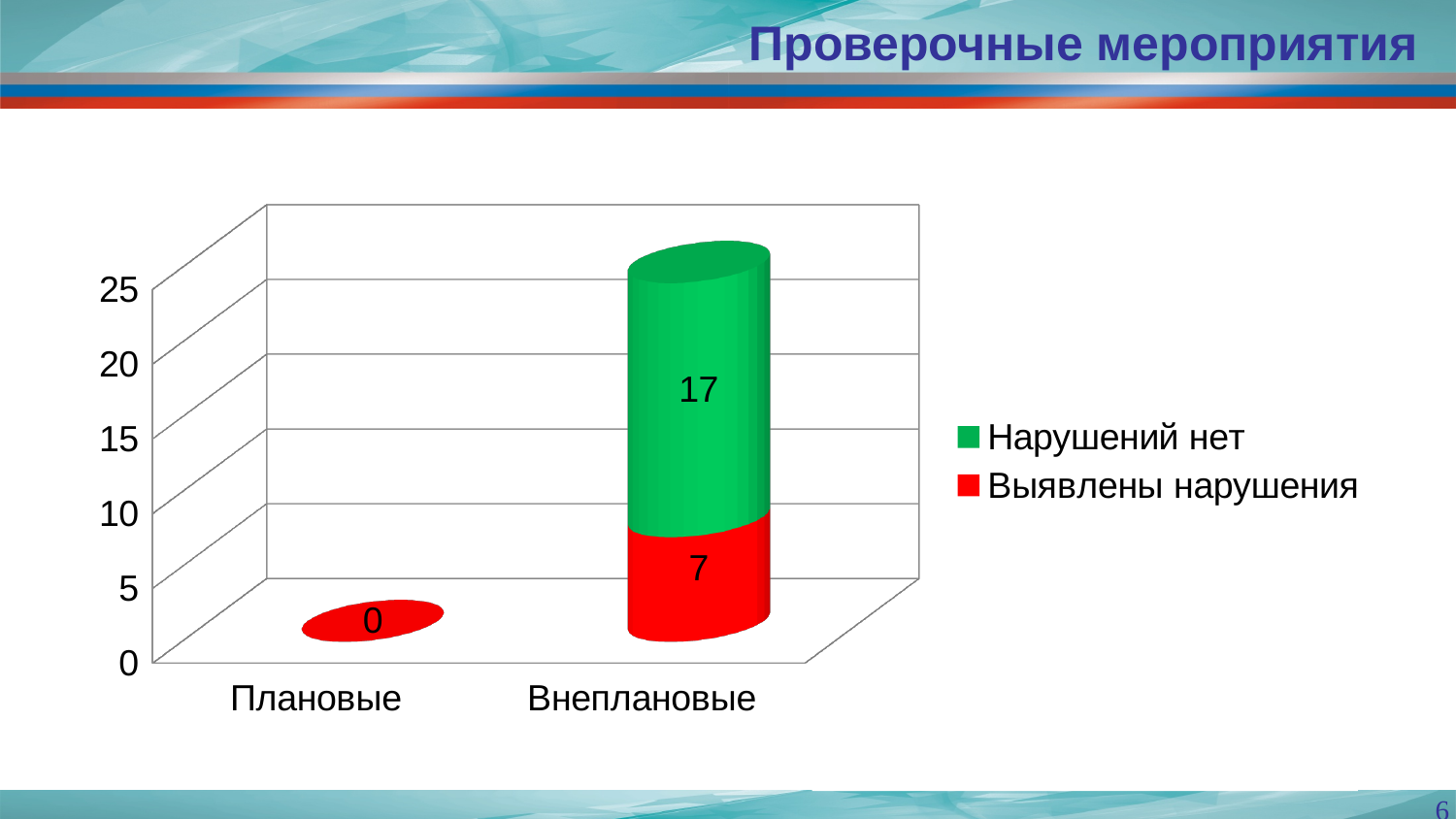
What kind of chart is shown on the slide? Bar chart What colour represents the 'Выявлены нарушения' series? Red For the 'Внеплановые' category, which series has the larger value: 'Нарушений нет' or 'Выявлены нарушения'? Нарушений нет What is the value of the 'Нарушений нет' series for the 'Внеплановые' category? 17 What is the title of the slide? Проверочные мероприятия What is the difference between the 'Нарушений нет' and 'Выявлены нарушения' values for 'Внеплановые'? 10 Which category has the taller stacked bar? Внеплановые How many series does the legend list? 2 What is the value of the 'Выявлены нарушения' series for the 'Плановые' category? 0 What is the total of the stacked bar for 'Внеплановые'? 24 What is the value of the 'Выявлены нарушения' series for the 'Внеплановые' category? 7 How many categories are shown on the x axis? 2